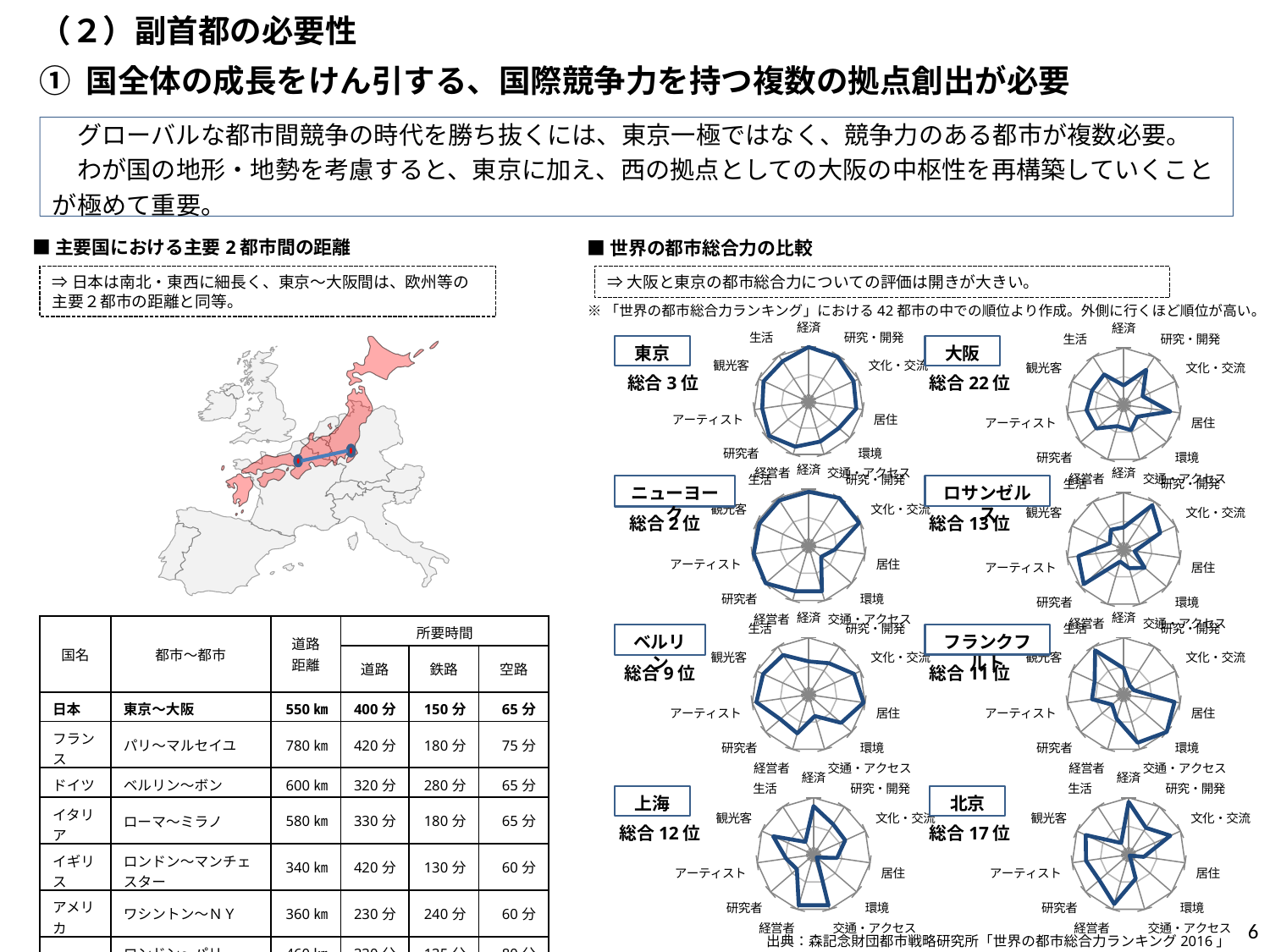
Which city among the eight radar charts has the best (lowest-numbered) overall rank? ニューヨーク How many axes (evaluation categories) does each radar chart have? 11 What overall rank (総合) is printed next to the 北京 radar chart? 総合 17 位 What overall rank (総合) is printed next to the ニューヨーク radar chart? 総合 2 位 What kind of chart is used to compare the cities' overall strength on the right side of the slide? Radar chart On the 経済 axis, which radar chart extends further outward, 東京 or 大阪? 東京 How many radar charts are shown under the heading 世界の都市総合力の比較? 8 Which city's radar chart is labelled 総合 12 位? 上海 Which city among the eight radar charts has the worst (highest-numbered) overall rank? 大阪 What overall rank (総合) is printed next to the 大阪 radar chart? 総合 22 位 According to the note above the radar charts, does a point further from the centre indicate a higher or lower rank? Higher rank What overall rank (総合) is printed next to the 東京 radar chart? 総合 3 位